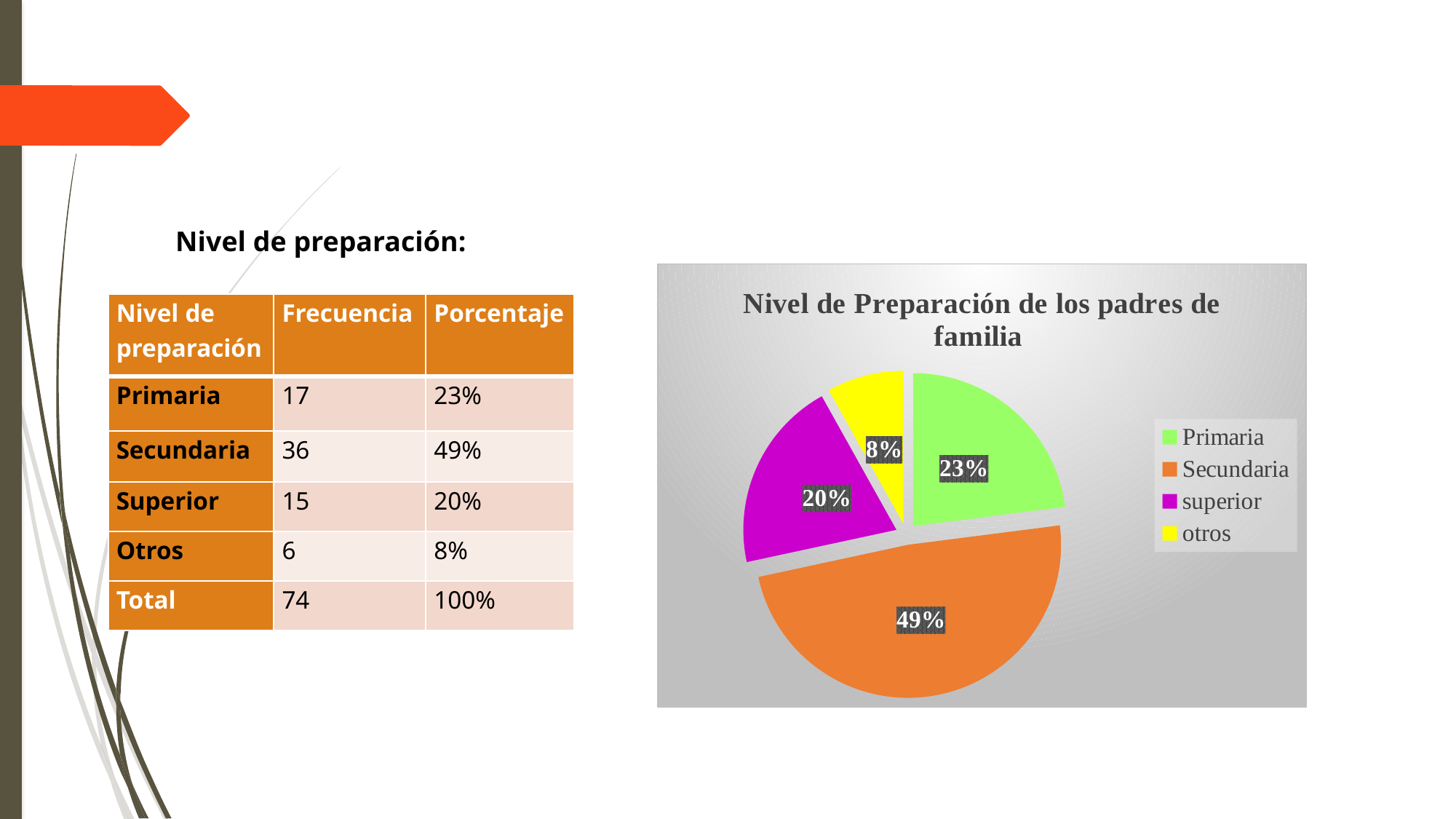
What type of chart is shown on the slide? pie chart What percentage does the otros slice show? 8% Which category has the largest slice of the pie? Secundaria What is the title of the chart? Nivel de Preparación de los padres de familia How many slices does the pie chart have? 4 How many entries does the legend list? 4 What percentage does the Primaria slice show? 23% Which slice is larger, Primaria or superior? Primaria What is the difference in percentage points between the Secundaria slice and the Primaria slice? 26 Which category has the smallest slice of the pie? otros What percentage does the Secundaria slice show? 49% What percentage does the superior slice show? 20%